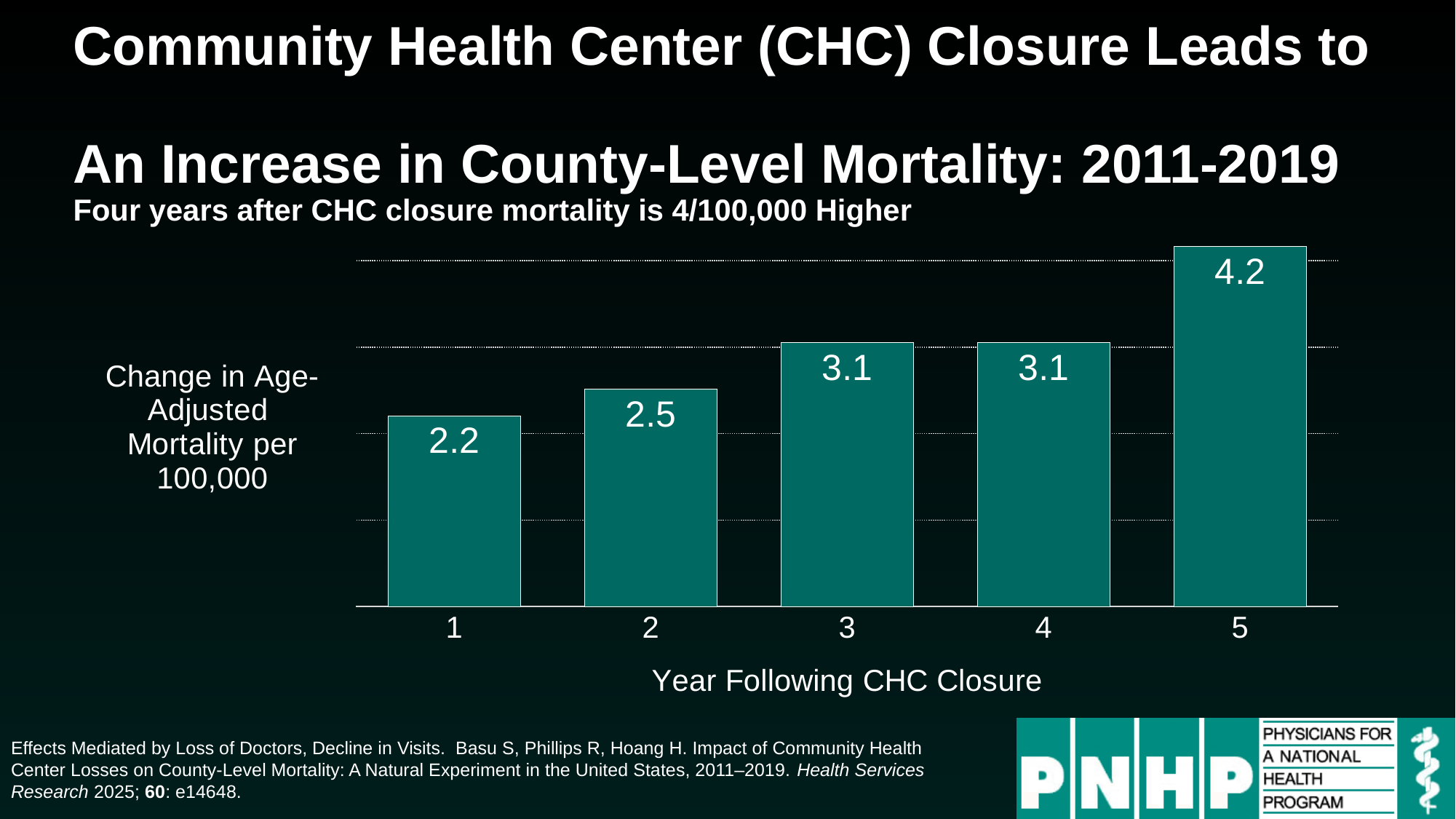
What is the difference between the change in mortality in year 5 and year 1 following CHC closure? 2.0 Which is larger, the change in mortality in year 2 or in year 5 following CHC closure? Year 5 What is the change in age-adjusted mortality per 100,000 in year 5 following CHC closure? 4.2 Do the values generally rise or fall from year 1 to year 5 following CHC closure? Rise Which year following CHC closure has the highest change in age-adjusted mortality? 5 Which year following CHC closure has the lowest change in age-adjusted mortality? 1 What is the change in age-adjusted mortality per 100,000 in year 3 following CHC closure? 3.1 How many years following CHC closure are plotted on the chart? 5 What kind of chart is shown on the slide? Bar chart What is the label of the x axis of the chart? Year Following CHC Closure What is the difference between the change in mortality in year 2 and year 3 following CHC closure? 0.6 What is the change in age-adjusted mortality per 100,000 in year 1 following CHC closure? 2.2